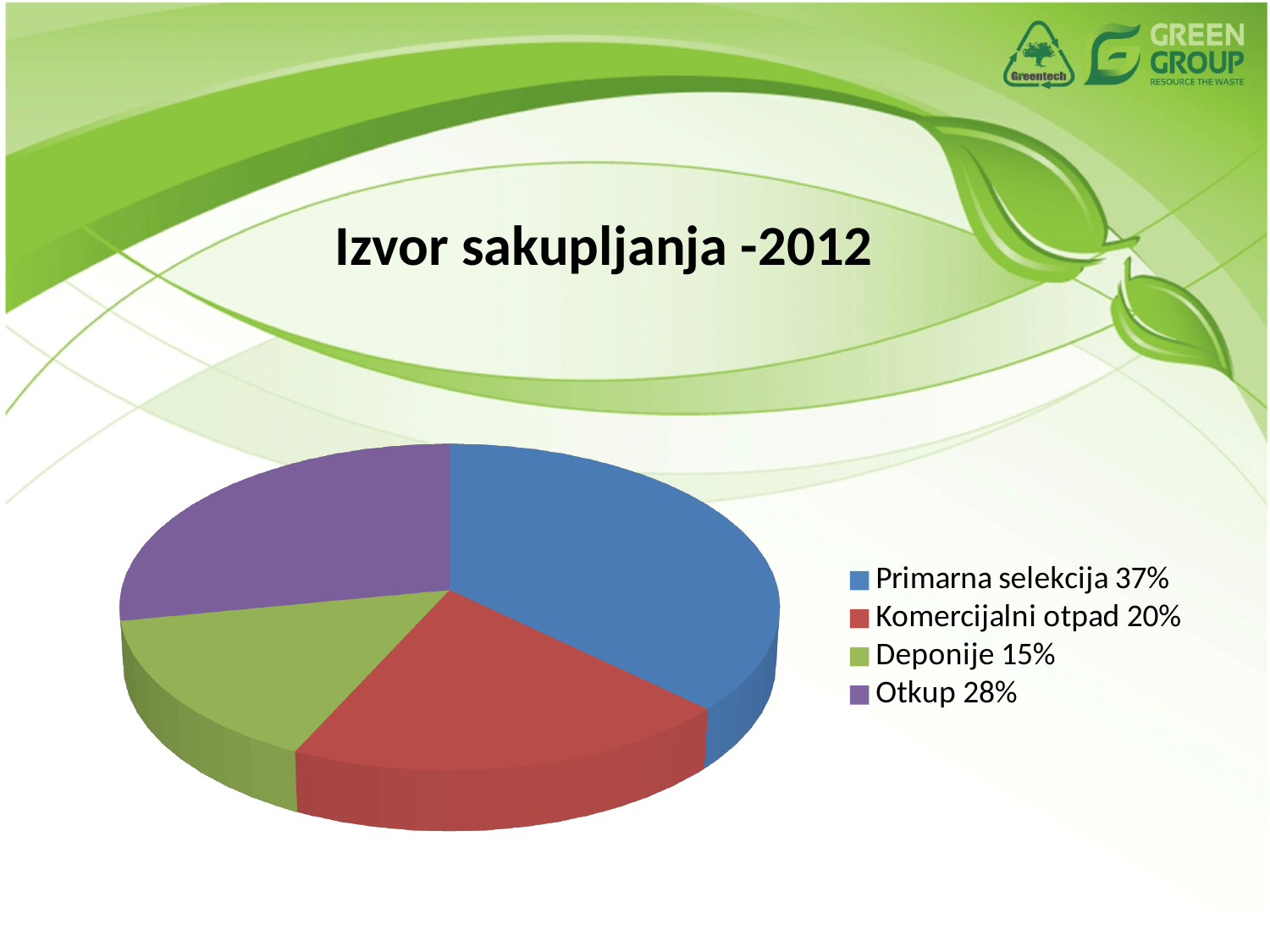
What colour is the slice for Deponije? Green Which category has the smallest share of the pie? Deponije What is the title of the chart? Izvor sakupljanja -2012 What share of the pie does Deponije have? 15% What share of the pie does Primarna selekcija have? 37% What type of chart is shown on the slide? Pie chart What share of the pie does Komercijalni otpad have? 20% What is the difference in percentage points between Primarna selekcija and Otkup? 9 Which is larger, the share for Komercijalni otpad or the share for Otkup? Otkup Which category has the largest share of the pie? Primarna selekcija How many categories does the pie chart have? 4